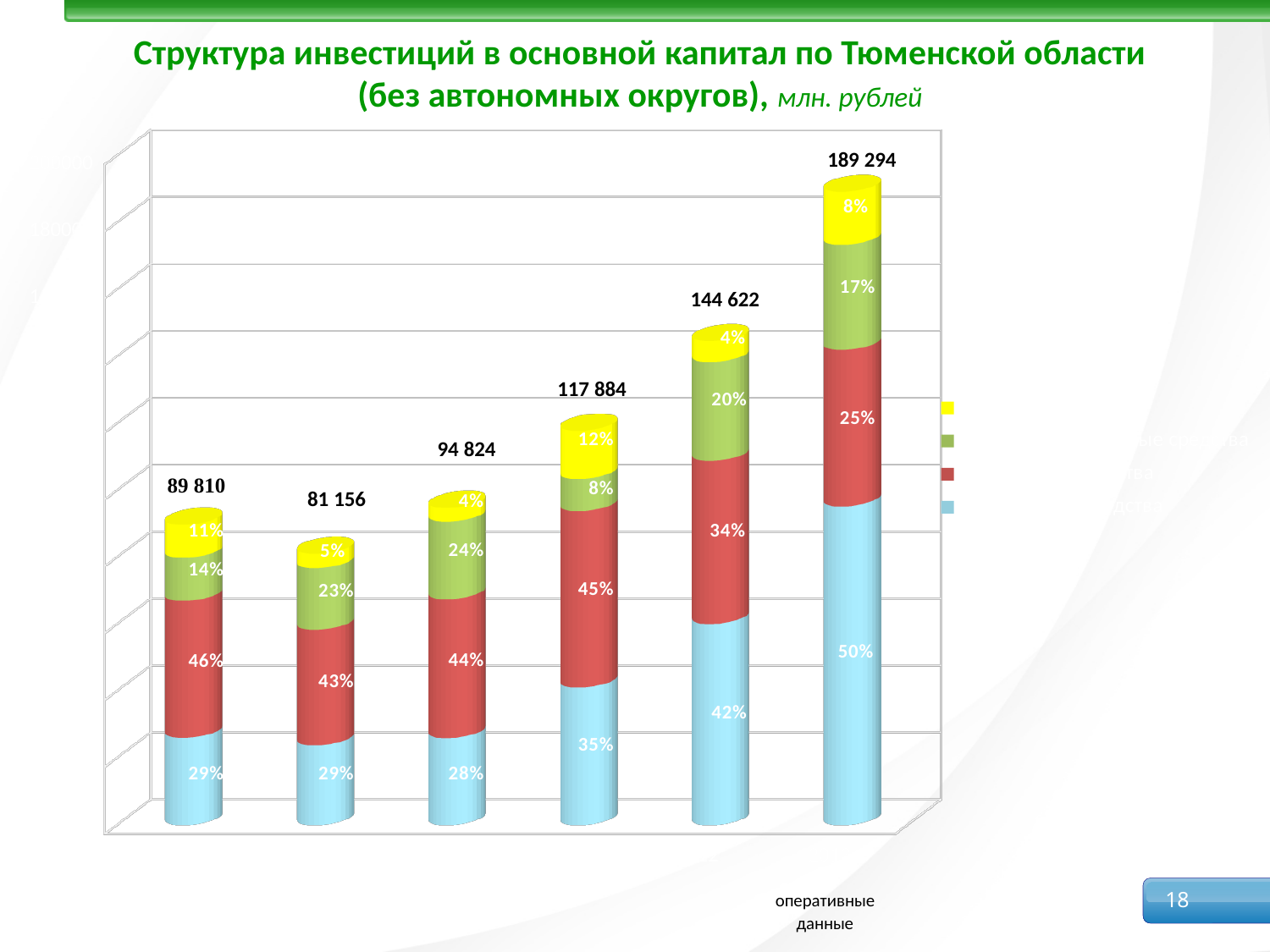
How many series (colour segments) does the legend list? 4 Which bar has the highest total value, and what is it? the rightmost bar, 189 294 What percentage does the blue (bottom) segment of the rightmost bar show? 50% How many bars are plotted in the chart? 6 Which bar has the lowest total value, and what is it? the second bar from the left, 81 156 What is the difference between the totals of the rightmost bar (189 294) and the fifth bar (144 622)? 44 672 What percentage does the yellow (top) segment of the fourth bar from the left show? 12% What percentage does the green segment of the fifth bar from the left show? 20% What kind of chart is shown on the slide? stacked bar chart In what units are the values given according to the chart title? млн. рублей What is the total value printed above the fourth bar from the left? 117 884 Which is larger: the red segment share in the first bar (46%) or in the third bar (44%)? the first bar